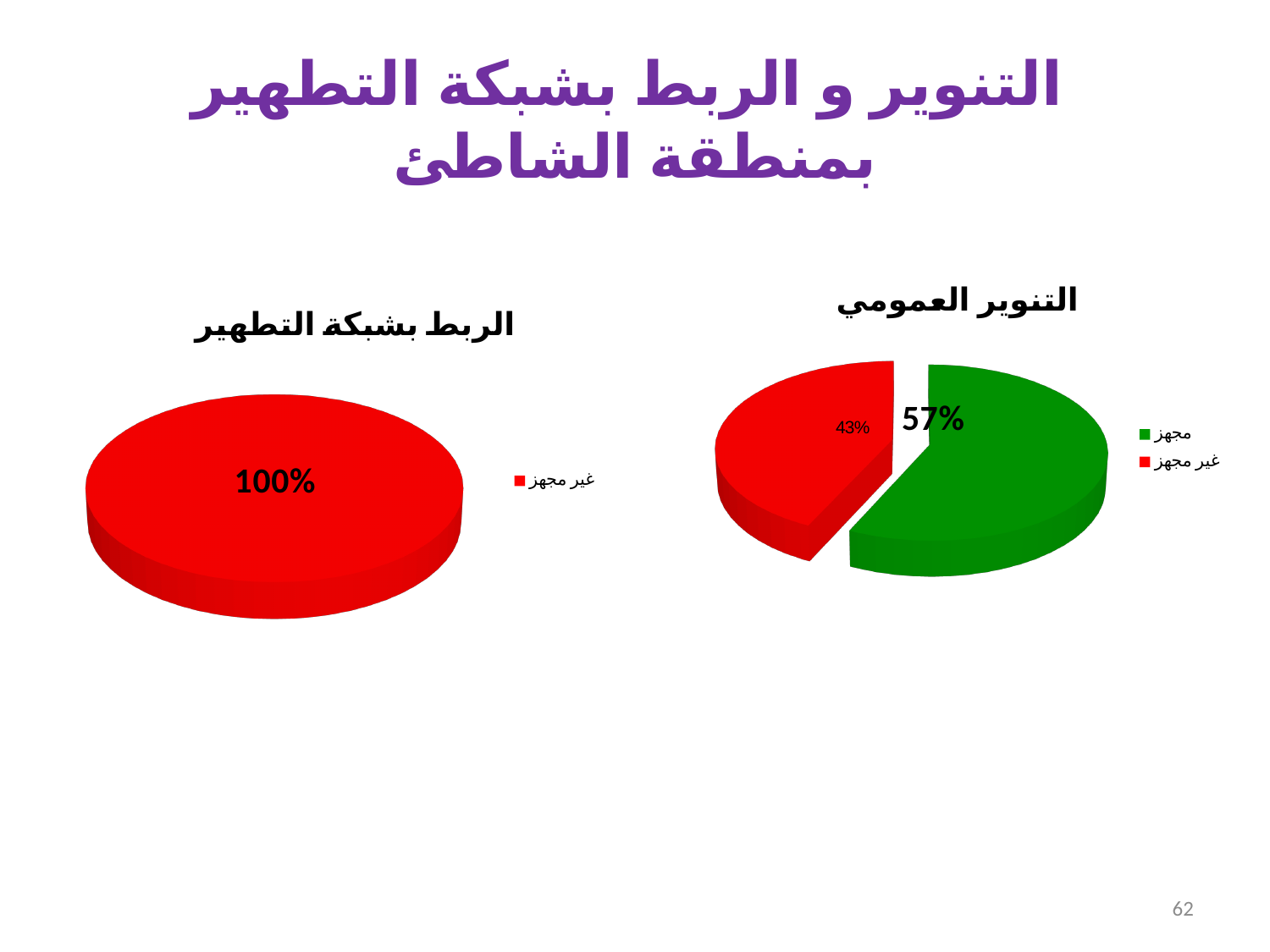
In the chart titled "التنوير العمومي", what is the difference between the shares of "مجهز" and "غير مجهز"? 14% What kind of chart is the chart titled "الربط بشبكة التطهير"? Pie chart How many entries does the legend of the chart titled "التنوير العمومي" list? 2 In the chart titled "التنوير العمومي", which is larger: the share of "مجهز" or the share of "غير مجهز"? مجهز In the chart titled "التنوير العمومي", what share is labelled for "مجهز"? 57% In the chart titled "التنوير العمومي", which category has the smallest slice? غير مجهز In the chart titled "التنوير العمومي", what share is labelled for "غير مجهز"? 43% In the chart titled "التنوير العمومي", which category has the largest slice? مجهز How many slices does the chart titled "الربط بشبكة التطهير" have? 1 How many slices does the chart titled "التنوير العمومي" have? 2 In the chart titled "التنوير العمومي", what colour is the slice for "مجهز"? Green In the chart titled "الربط بشبكة التطهير", what share is labelled for "غير مجهز"? 100%